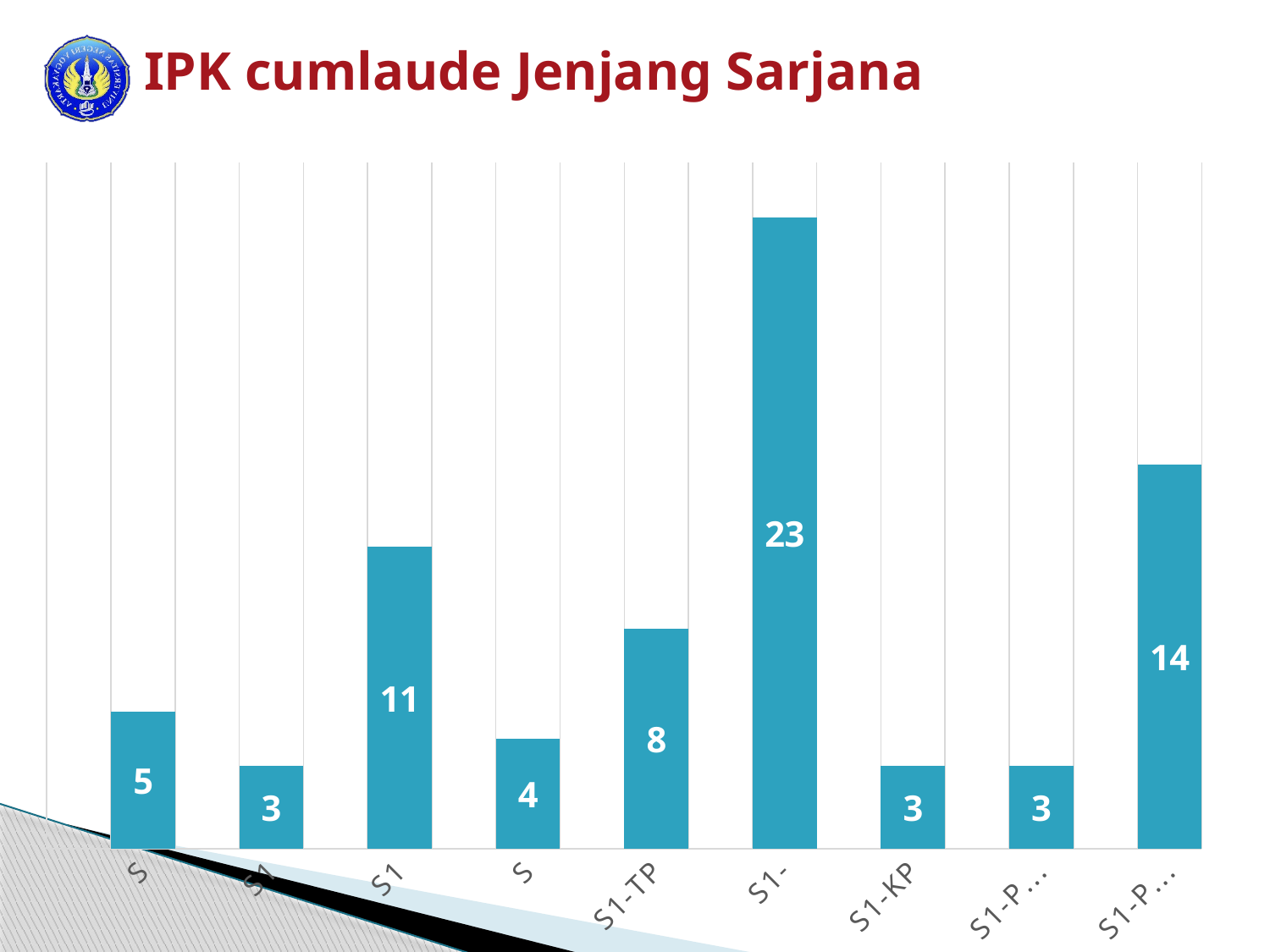
What is the title of the slide containing the chart? IPK cumlaude Jenjang Sarjana What is the value of the bar labelled S1-KP? 3 What is the value of the tallest bar in the chart? 23 Which bar is larger, S1-TP or S1-KP? S1-TP What is the difference between the tallest bar (23) and the bar labelled S1-TP? 15 What is the difference between the rightmost bar and the bar labelled S1-KP? 11 What kind of chart is shown on the slide? bar chart What is the value of the last (rightmost) bar in the chart? 14 What is the value of the first (leftmost) bar in the chart? 5 What is the value of the bar labelled S1-TP? 8 What is the value of the third bar from the left? 11 How many bars does the chart contain? 9